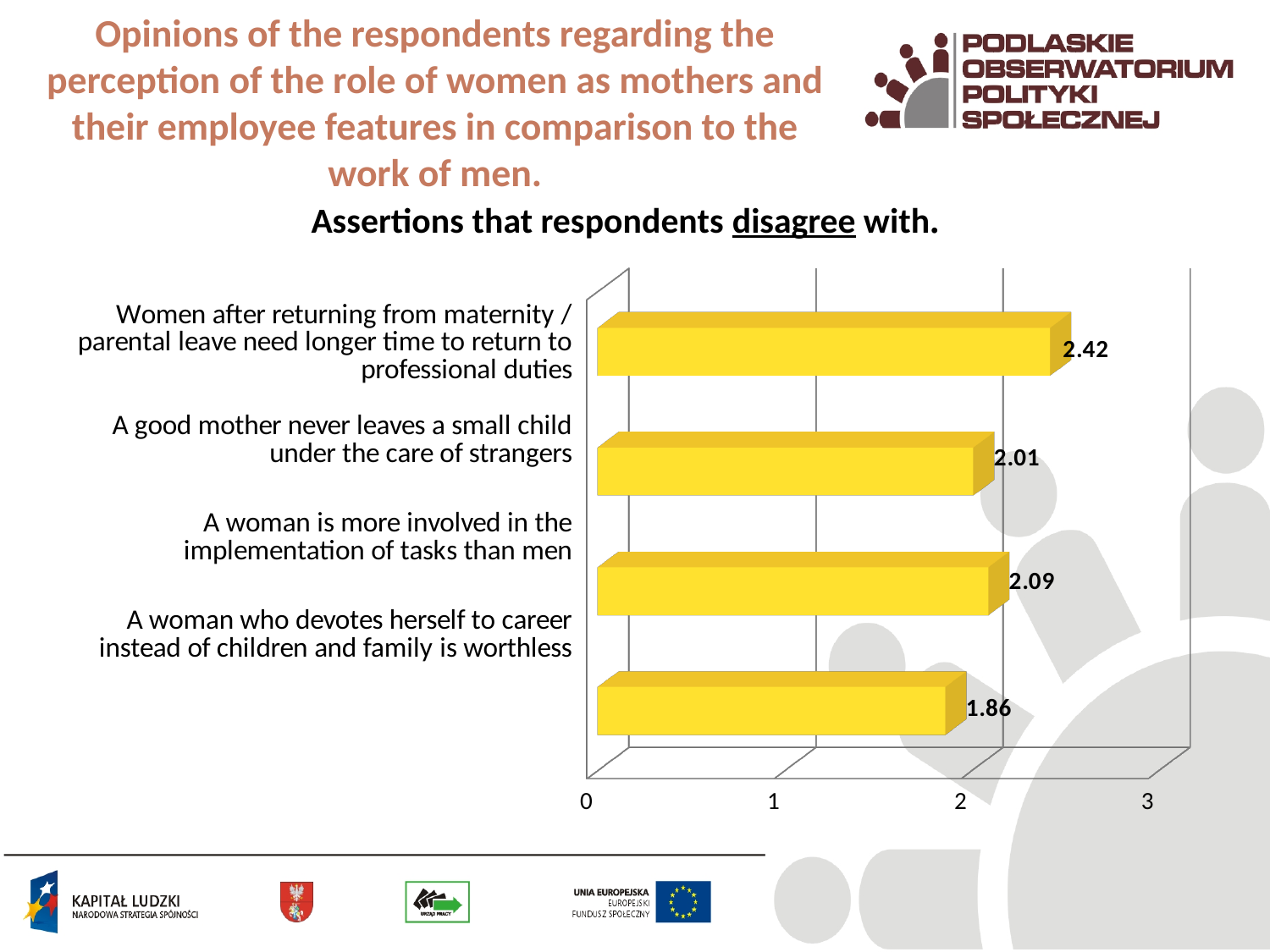
What is the difference between the highest value (2.42) and the lowest value (1.86)? 0.56 What is the value for "A woman who devotes herself to career instead of children and family is worthless"? 1.86 What is the value for "Women after returning from maternity / parental leave need longer time to return to professional duties"? 2.42 What is the value for "A woman is more involved in the implementation of tasks than men"? 2.09 What is the maximum value shown on the horizontal axis? 3 What is the value for "A good mother never leaves a small child under the care of strangers"? 2.01 Which is larger: the value for "A woman is more involved in the implementation of tasks than men" or the value for "A good mother never leaves a small child under the care of strangers"? A woman is more involved in the implementation of tasks than men Which assertion has the highest value? Women after returning from maternity / parental leave need longer time to return to professional duties What kind of chart is shown on the slide? Bar chart Which assertion has the lowest value? A woman who devotes herself to career instead of children and family is worthless How many assertions are shown in the chart? 4 Is the value for "A woman who devotes herself to career instead of children and family is worthless" greater or less than 2? less